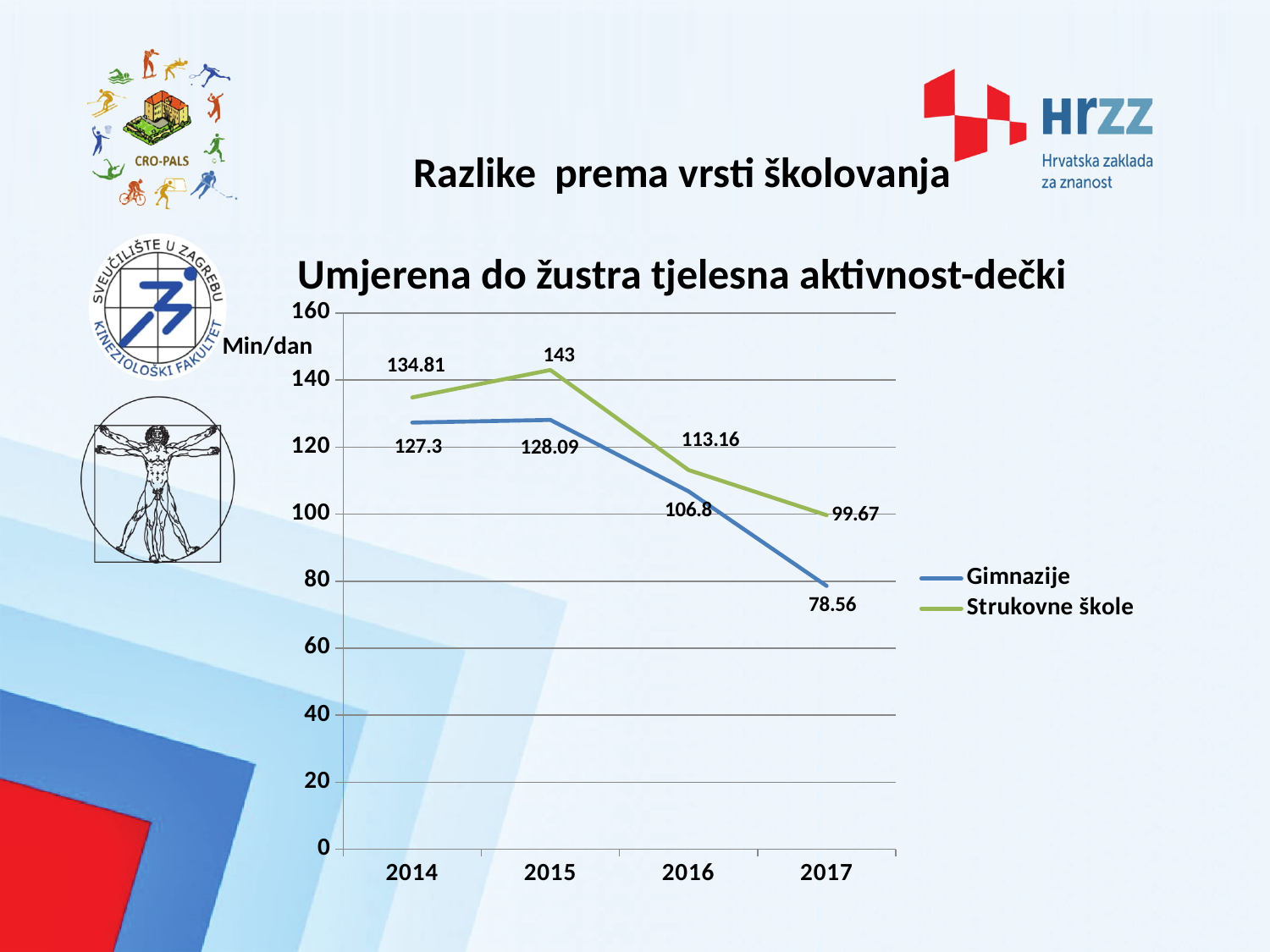
Which series has the larger value in 2016, Gimnazije or Strukovne škole? Strukovne škole In which year is the value for Strukovne škole highest? 2015 What is the difference between Strukovne škole and Gimnazije in 2017? 21.11 What is the value for Gimnazije in 2017? 78.56 What is the value for Strukovne škole in 2016? 113.16 What is the value for Strukovne škole in 2015? 143 In which year is the value for Gimnazije lowest? 2017 What is the title of the chart? Umjerena do žustra tjelesna aktivnost-dečki How many years are shown on the x axis? 4 What type of chart is shown on the slide? Line chart What is the value for Gimnazije in 2014? 127.3 How many series does the legend list? 2